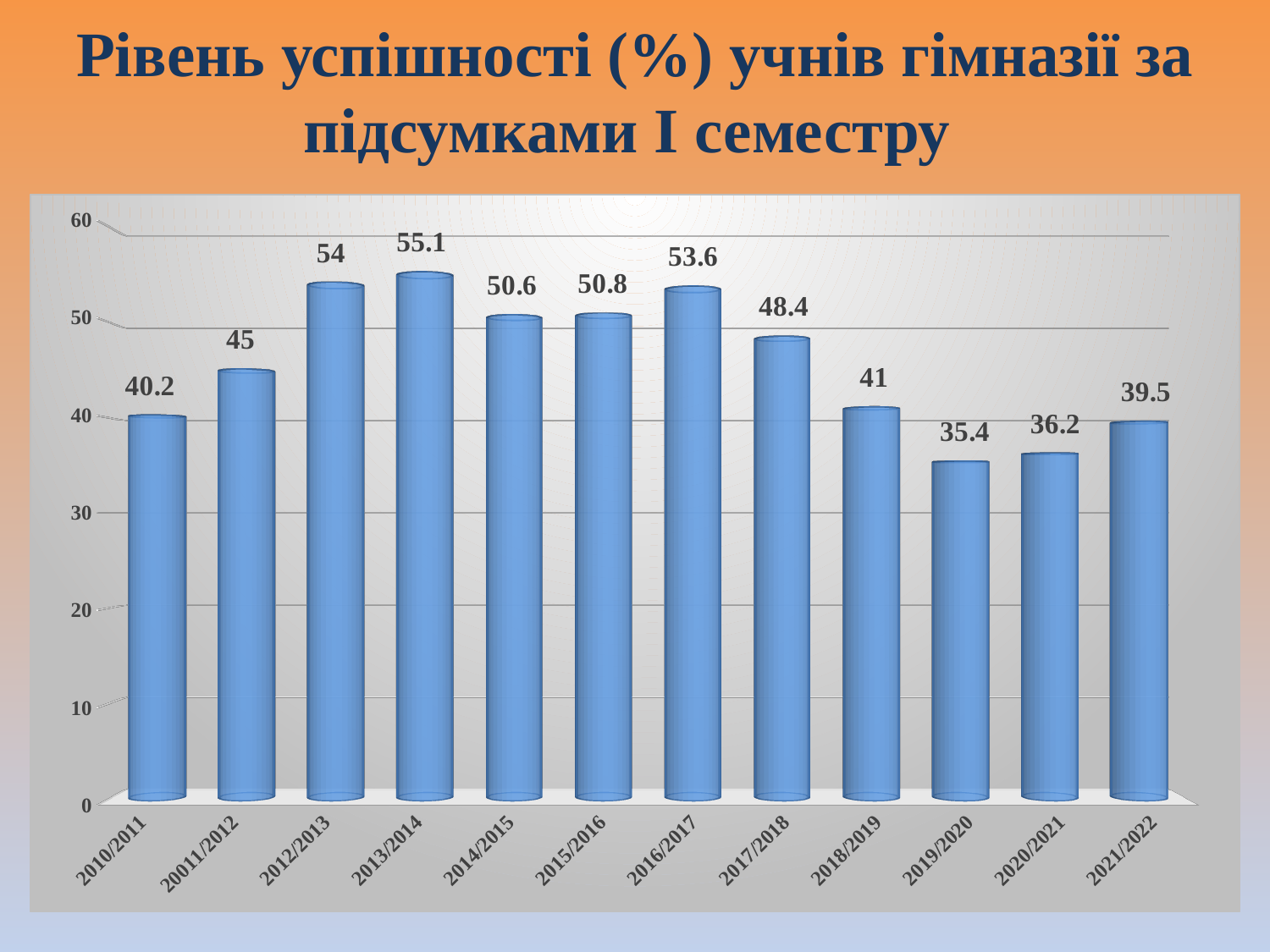
What kind of chart is shown on the slide? Bar chart What is the value for 2013/2014? 55.1 Which is larger, the value for 2012/2013 or the value for 2016/2017? 2012/2013 What is the difference between the values for 2017/2018 and 2018/2019? 7.4 What is the value for 2016/2017? 53.6 How many years are shown on the x axis? 12 What is the difference between the values for 2013/2014 and 2019/2020? 19.7 Which year has the lowest value? 2019/2020 What is the value for 2019/2020? 35.4 Do the values rise or fall from 2016/2017 to 2019/2020? Fall Which year has the highest value? 2013/2014 What is the value for 2021/2022? 39.5